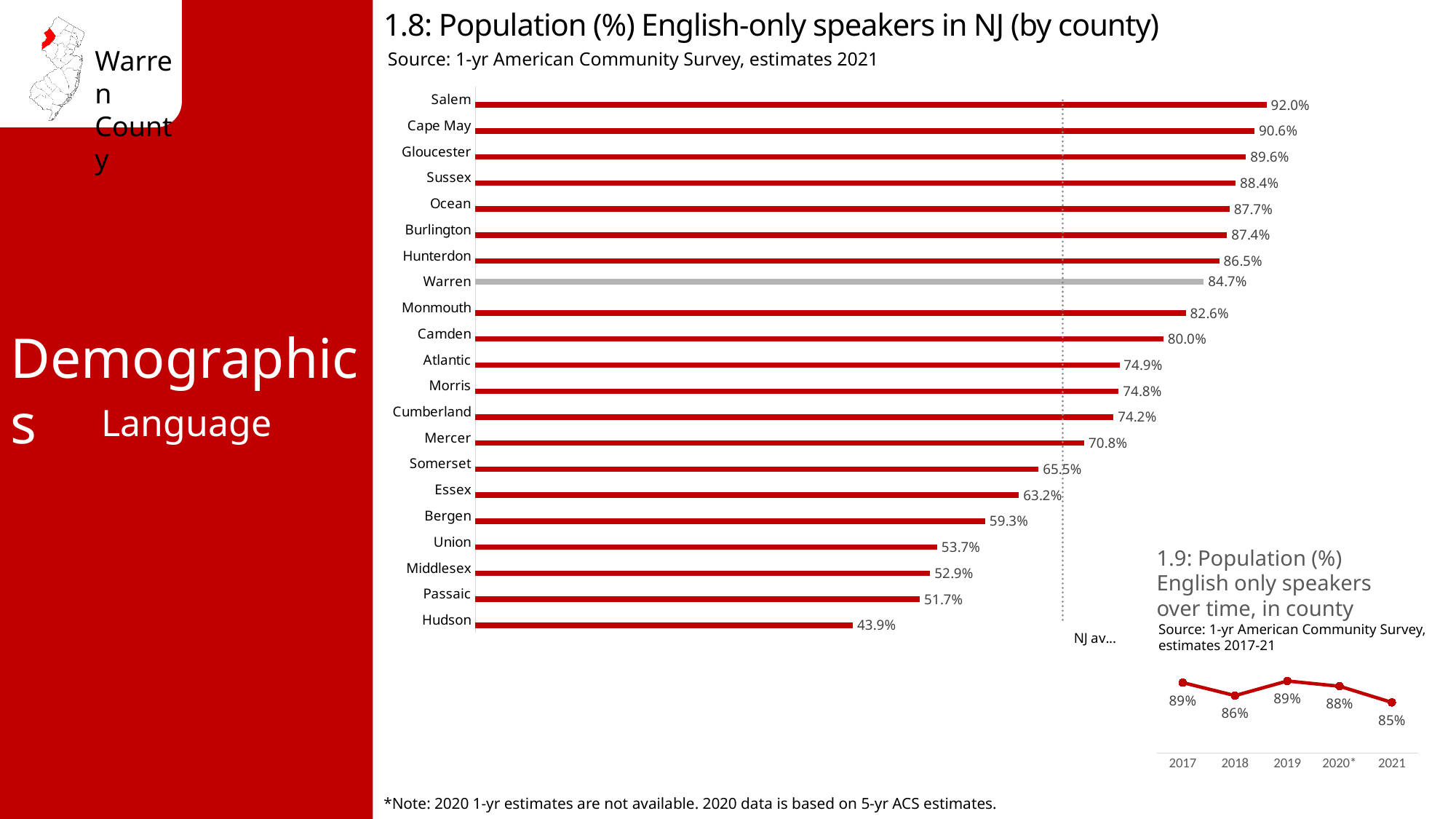
In chart 1.9 (English only speakers over time), what is the value for 2021? 85% In chart 1.8 (English-only speakers by county), which is larger, the value for Bergen or the value for Essex? Essex In chart 1.8 (English-only speakers by county), what is the value for Camden? 80.0% What kind of chart is chart 1.9 (English only speakers over time)? Line chart In chart 1.9 (English only speakers over time), what is the value for 2018? 86% In chart 1.8 (English-only speakers by county), which county has the lowest value? Hudson What kind of chart is chart 1.8 (English-only speakers by county)? Bar chart In chart 1.8 (English-only speakers by county), how many counties are plotted? 21 In chart 1.8 (English-only speakers by county), which county has the highest value? Salem In chart 1.8 (English-only speakers by county), what is the value for Warren? 84.7% In chart 1.9 (English only speakers over time), how many years are plotted? 5 In chart 1.8 (English-only speakers by county), what is the difference between Salem and Hudson? 48.1%